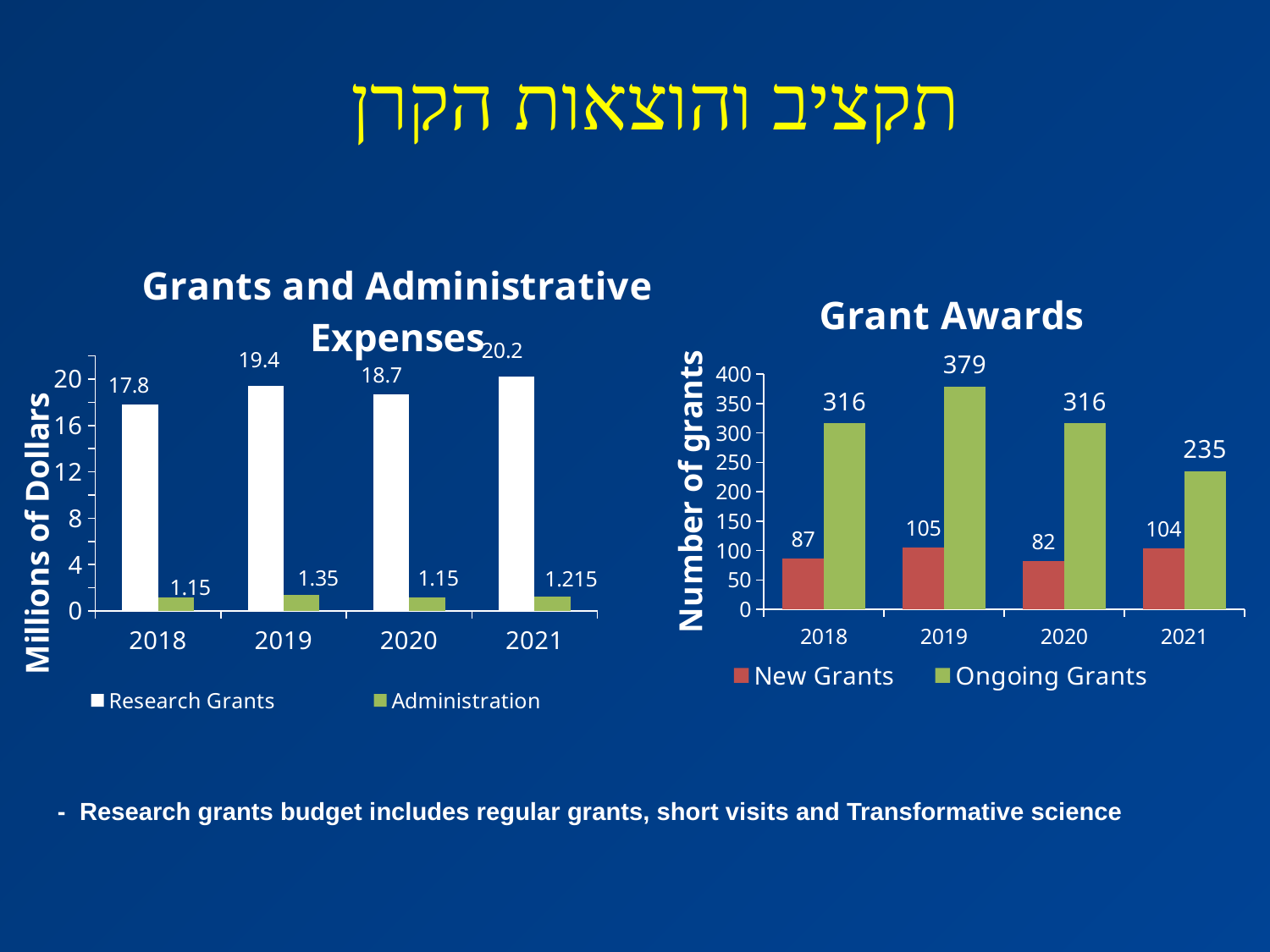
In the 'Grants and Administrative Expenses' chart, which year has the highest Research Grants value? 2021 In the 'Grant Awards' chart, what is the number of Ongoing Grants in 2019? 379 In the 'Grant Awards' chart, what is the number of New Grants in 2020? 82 In the 'Grant Awards' chart, which is larger: New Grants in 2019 or New Grants in 2021? New Grants in 2019 In the 'Grant Awards' chart, which year has the lowest number of Ongoing Grants? 2021 In the 'Grants and Administrative Expenses' chart, what is the value for Administration in 2021? 1.215 In the 'Grants and Administrative Expenses' chart, what is the value for Research Grants in 2019? 19.4 What kind of chart is the 'Grant Awards' chart? Bar chart In the 'Grants and Administrative Expenses' chart, what is the difference between Research Grants in 2021 and 2018? 2.4 In the 'Grants and Administrative Expenses' chart, how many series does the legend list? 2 In the 'Grant Awards' chart, how many years are shown on the x axis? 4 In the 'Grant Awards' chart, what is the difference between Ongoing Grants in 2019 and 2021? 144